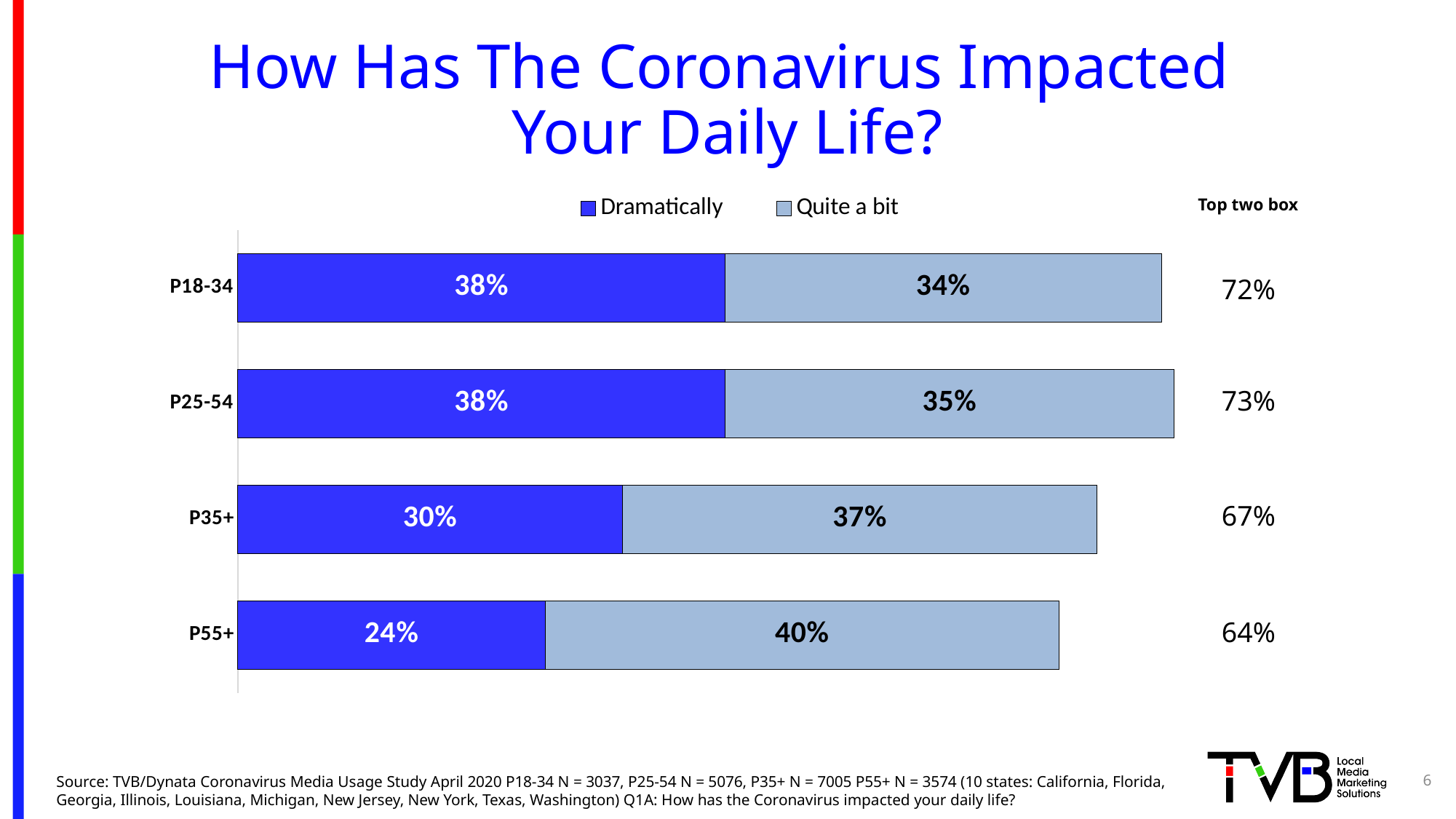
How many series does the legend list? 2 What is the difference between the "Dramatically" values for P18-34 and P55+? 14% What is the "Dramatically" value for P18-34? 38% Which category has the highest "Quite a bit" value? P55+ What kind of chart is shown on the slide? Stacked bar chart Which is larger for P35+: the "Dramatically" value or the "Quite a bit" value? Quite a bit What is the total of the stacked bar for P25-54? 73% How many age categories are shown in the chart? 4 Which category has the lowest "Dramatically" value? P55+ What is the "Quite a bit" value for P55+? 40% What is the "Quite a bit" value for P35+? 37% What is the Top two box value for P55+? 64%